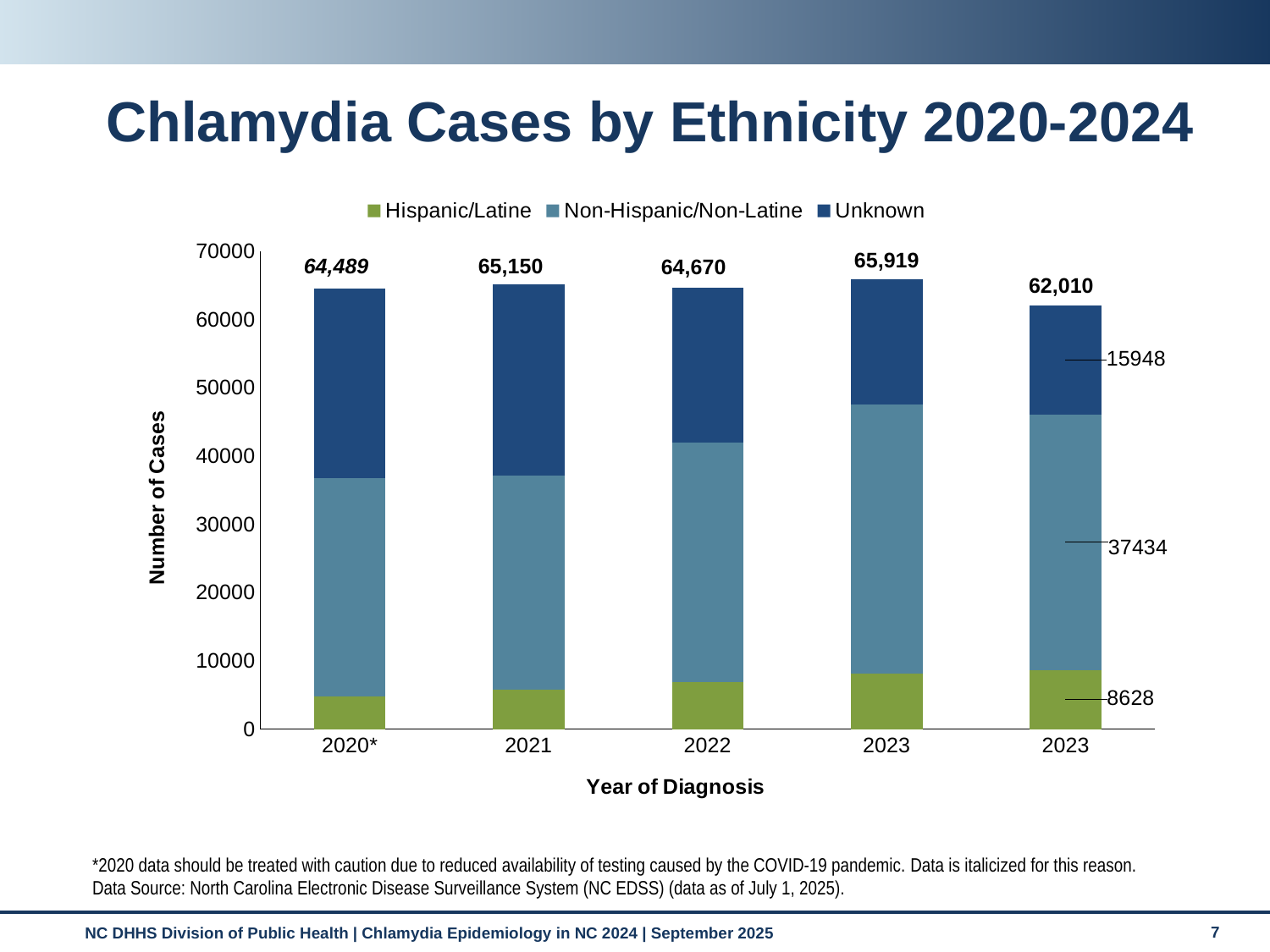
How many series does the legend list? 3 What is the lowest bar total shown on the chart? 62,010 Which total is larger, 2021 or 2022? 2021 Is the Hispanic/Latine value for 2021 greater or less than 10000? less What is the total number of chlamydia cases shown for 2021? 65,150 How many bars are shown on the chart? 5 What is the difference between the highest bar total (65,919) and the lowest bar total (62,010)? 3,909 What is the Hispanic/Latine value labeled on the rightmost bar? 8628 Which year has the highest total number of cases? 2023 (65,919) What is the Unknown value labeled on the rightmost bar? 15948 What is the Non-Hispanic/Non-Latine value labeled on the rightmost bar? 37434 What is the total number of cases shown for 2020*? 64,489